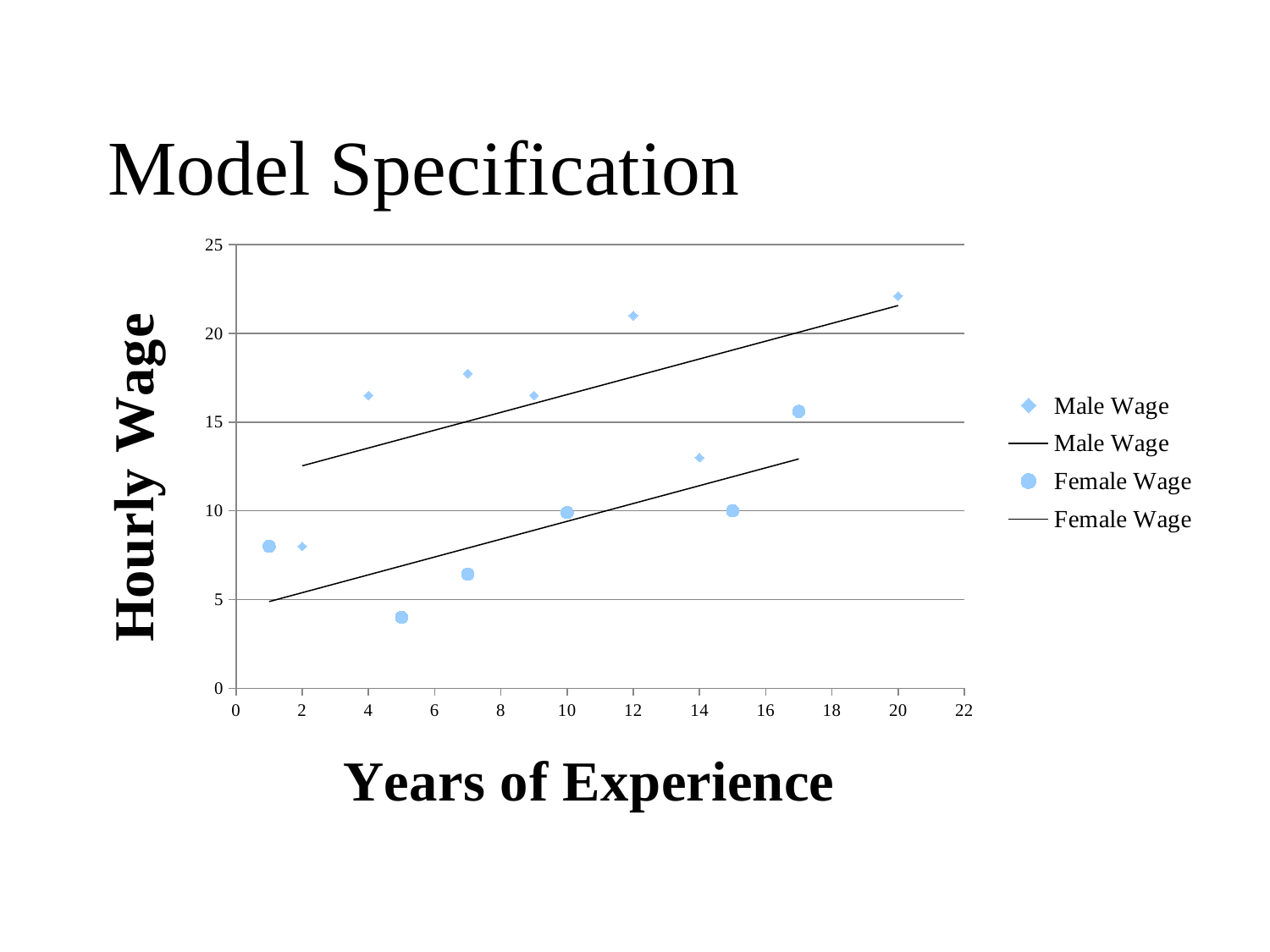
What is the label of the y axis? Hourly Wage Is the Female Wage at 5 years of experience greater or less than 5? less At 7 years of experience, which is larger: the Male Wage or the Female Wage? Male Wage At how many years of experience is the lowest Female Wage point plotted? 5 How many Male Wage data points are plotted? 7 How many entries does the legend list? 4 How many Female Wage data points are plotted? 6 What is the label of the x axis? Years of Experience What kind of chart is shown on the slide? Scatter chart Is the Male Wage at 20 years of experience greater or less than 20? greater At how many years of experience is the highest Male Wage point plotted? 20 Do the Male Wage and Female Wage trend lines rise or fall as years of experience increase? Rise